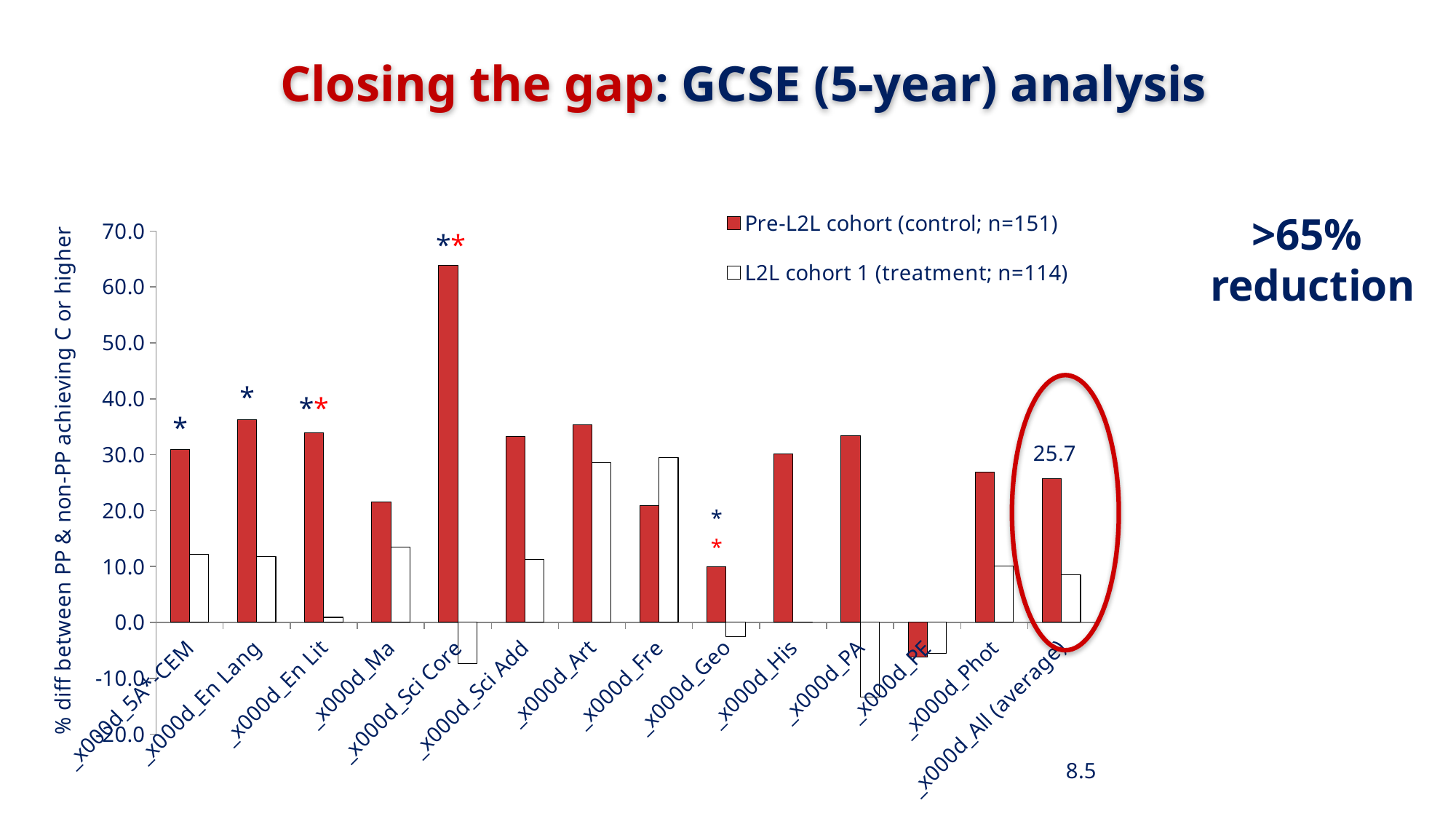
Is the Pre-L2L cohort value for Sci Core greater or less than 60.0? greater How many series does the legend list? 2 Is the Pre-L2L cohort value for Geo greater or less than 20.0? less How many categories are plotted along the x axis? 14 Which category has the lowest Pre-L2L cohort (control) value? PE What kind of chart is shown on the slide? bar chart What is the value for the Pre-L2L cohort (control) in the All (average) category? 25.7 Which category has the highest Pre-L2L cohort (control) value? Sci Core What is the value for L2L cohort 1 (treatment) in the All (average) category? 8.5 In the Fre category, which series has the larger value, Pre-L2L cohort (control) or L2L cohort 1 (treatment)? L2L cohort 1 (treatment) What is the difference between the Pre-L2L cohort and L2L cohort 1 values in the All (average) category? 17.2 What is the label on the y axis of the chart? % diff between PP & non-PP achieving C or higher